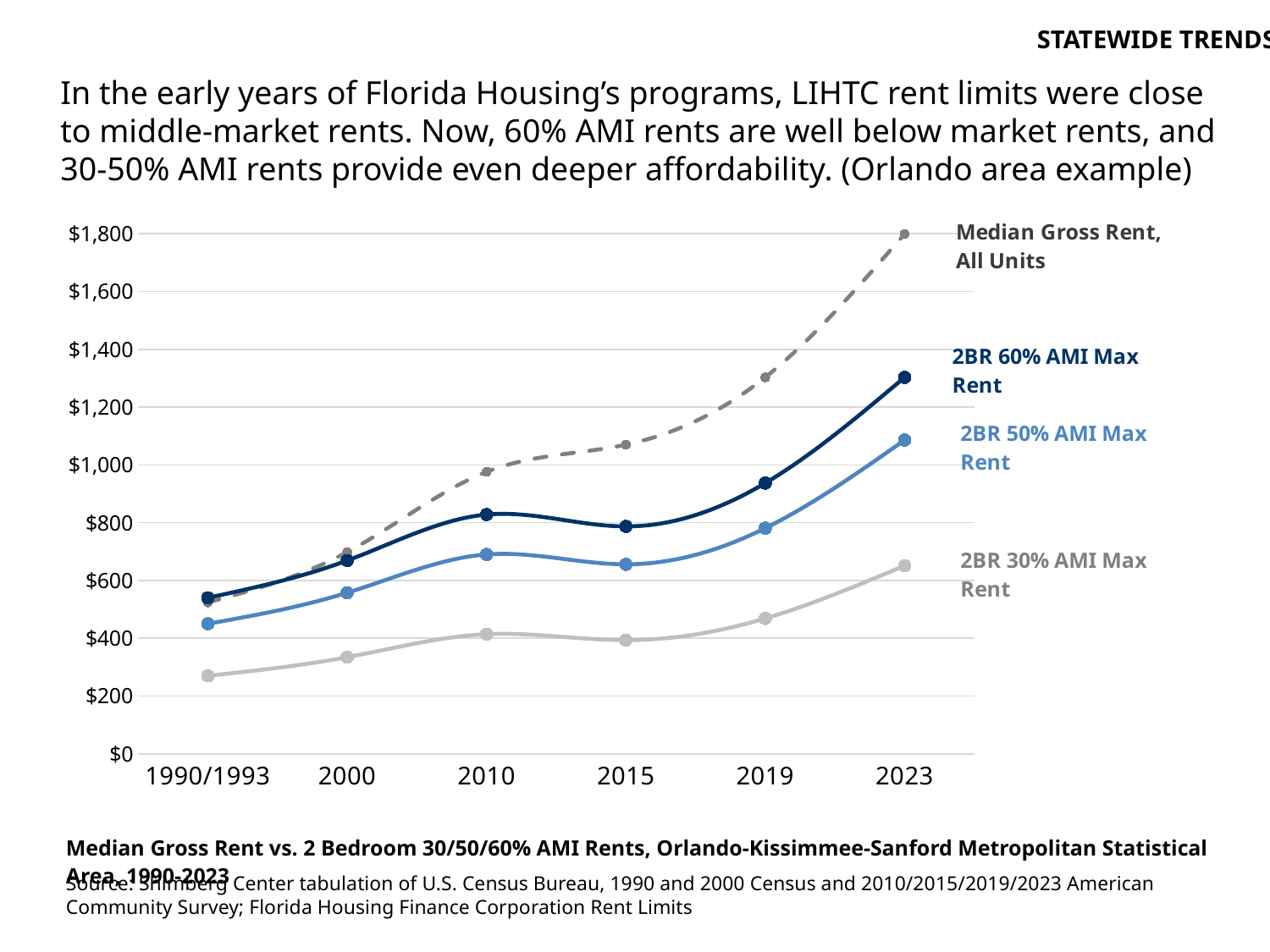
Is the 2BR 50% AMI Max Rent value for 2010 greater or less than $800? less What kind of chart is shown on the slide? Line chart In which year is the 2BR 60% AMI Max Rent at its lowest? 1990/1993 In which year is the Median Gross Rent, All Units at its highest? 2023 Which is larger for 2BR 60% AMI Max Rent: the 2010 value or the 2015 value? 2010 Does the Median Gross Rent, All Units series rise or fall from 1990/1993 to 2023? Rise Is the Median Gross Rent, All Units value for 2019 greater or less than $1,200? greater How many data series are labelled on the chart? 4 Which series has the lowest value in 2023? 2BR 30% AMI Max Rent Is the 2BR 30% AMI Max Rent value for 1990/1993 greater or less than $400? less Which series has the highest value in 2023? Median Gross Rent, All Units How many time points are plotted along the x axis? 6